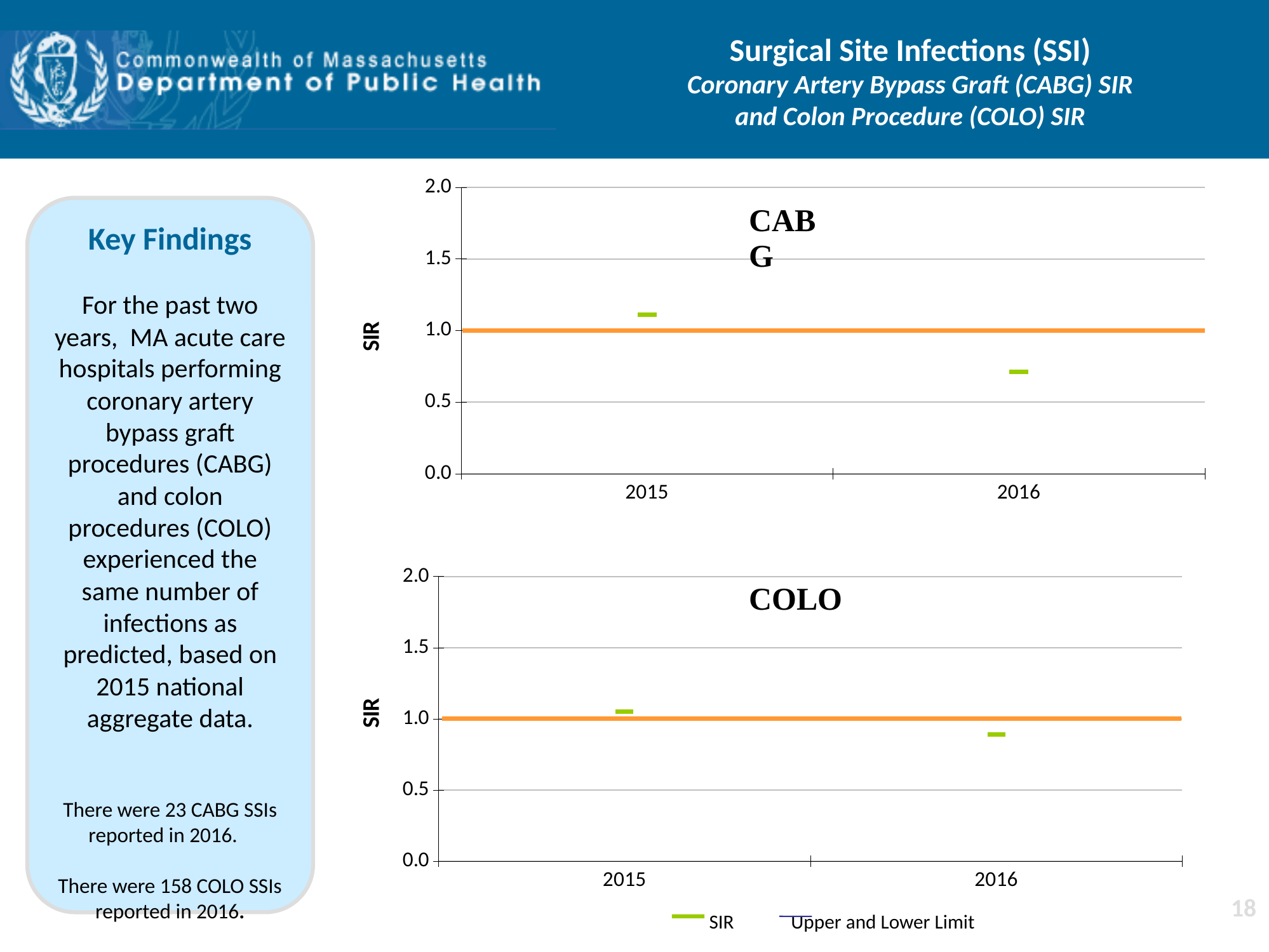
In the CABG chart, which year has the higher SIR, 2015 or 2016? 2015 In the CABG chart, does the SIR rise or fall from 2015 to 2016? fall In the CABG chart, is the SIR value for 2016 greater or less than 1.0? less In the COLO chart, which year has the higher SIR, 2015 or 2016? 2015 In the COLO chart, is the SIR value for 2016 greater or less than 1.0? less In the COLO chart, is the SIR value for 2015 greater or less than 0.5? greater What is the label on the y axis of the CABG chart? SIR In the COLO chart, does the SIR rise or fall from 2015 to 2016? fall How many series does the legend below the COLO chart list? 2 How many years are shown on the x axis of the COLO chart? 2